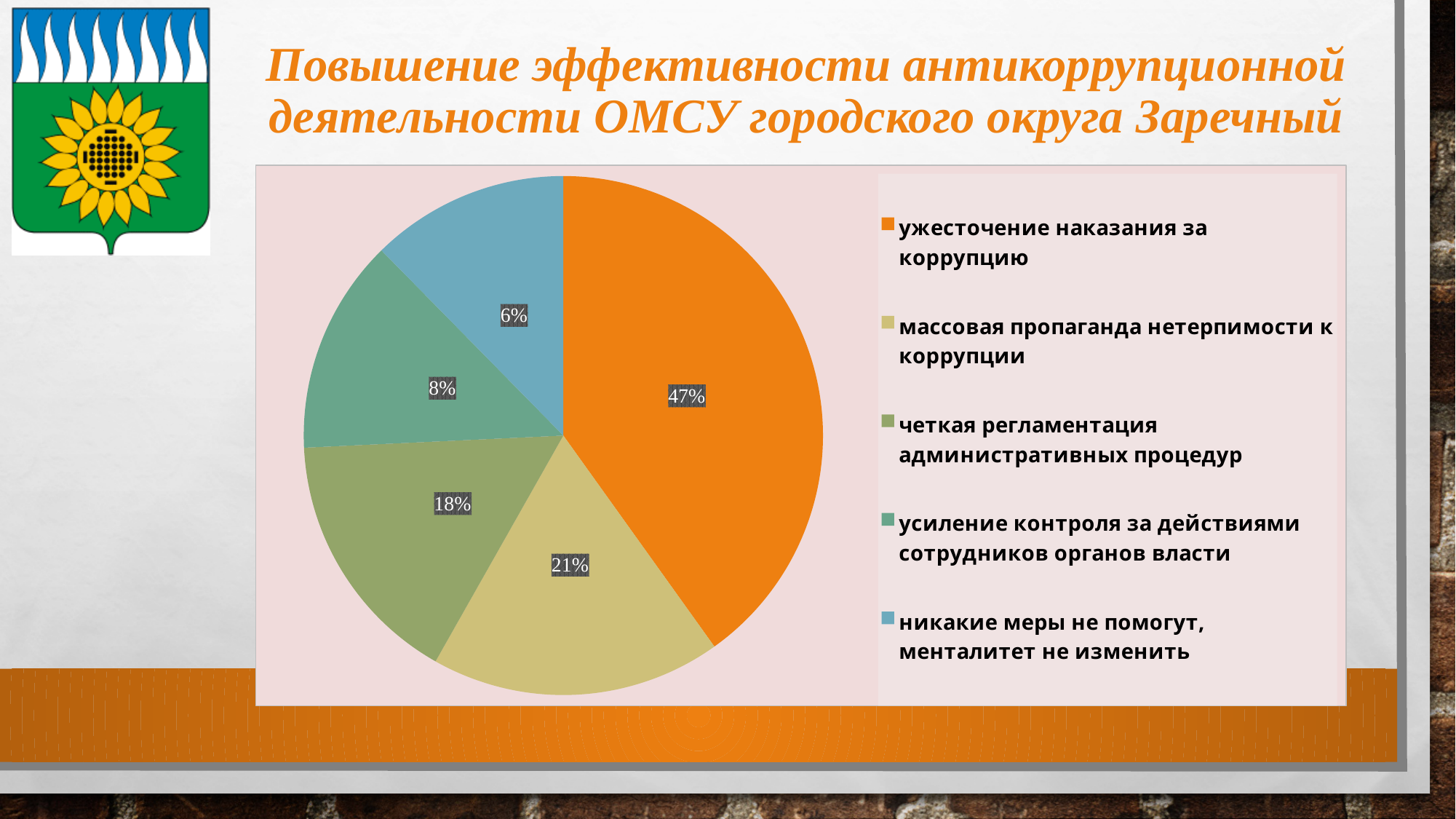
What share of the pie does "четкая регламентация административных процедур" have? 18% What share of the pie does "никакие меры не помогут, менталитет не изменить" have? 6% What colour is the slice for "никакие меры не помогут, менталитет не изменить"? blue What is the difference in percentage points between "ужесточение наказания за коррупцию" and "массовая пропаганда нетерпимости к коррупции"? 26 percentage points What share of the pie does "усиление контроля за действиями сотрудников органов власти" have? 8% Which is larger: the slice for "четкая регламентация административных процедур" or the slice for "усиление контроля за действиями сотрудников органов власти"? четкая регламентация административных процедур Which category has the smallest slice of the pie? никакие меры не помогут, менталитет не изменить What share of the pie does "массовая пропаганда нетерпимости к коррупции" have? 21% What type of chart is shown on the slide? pie chart What share of the pie does "ужесточение наказания за коррупцию" have? 47% Which category has the largest slice of the pie? ужесточение наказания за коррупцию How many categories does the pie chart have? 5